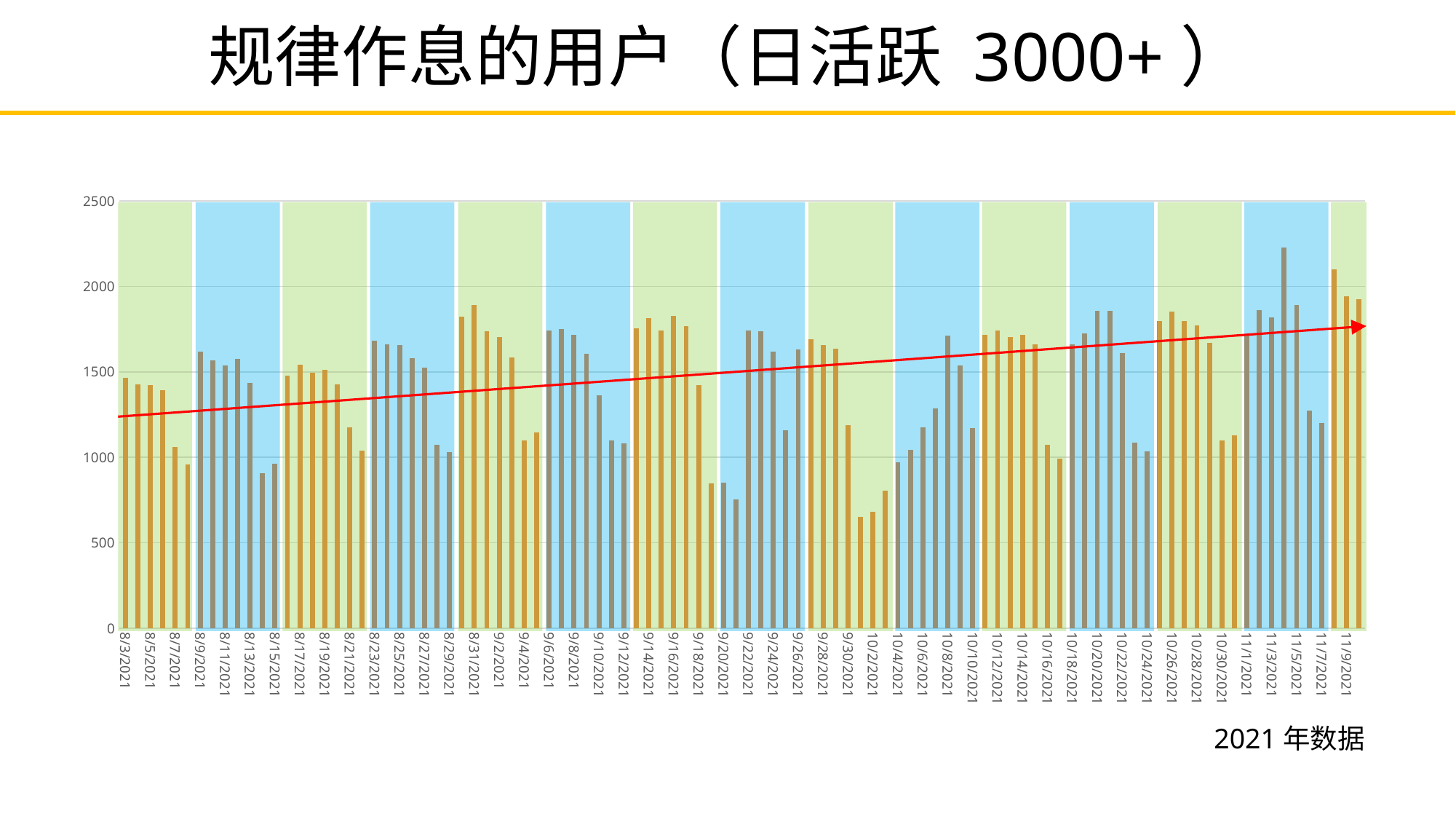
What is the title of the chart on the slide? 规律作息的用户（日活跃 3000+） What is the highest value shown on the y axis of the chart? 2500 Which is larger, the value for 8/7/2021 or the value for 8/9/2021? 8/9/2021 Is the value for 9/20/2021 greater or less than 1000? less Is the value for 10/2/2021 greater or less than 1000? less Is the value for 10/20/2021 greater or less than 1500? greater What kind of chart is shown on the slide? bar chart Which is larger, the value for 10/2/2021 or the value for 10/20/2021? 10/20/2021 According to the red arrow, do the values generally rise or fall from left to right along the x axis? rise